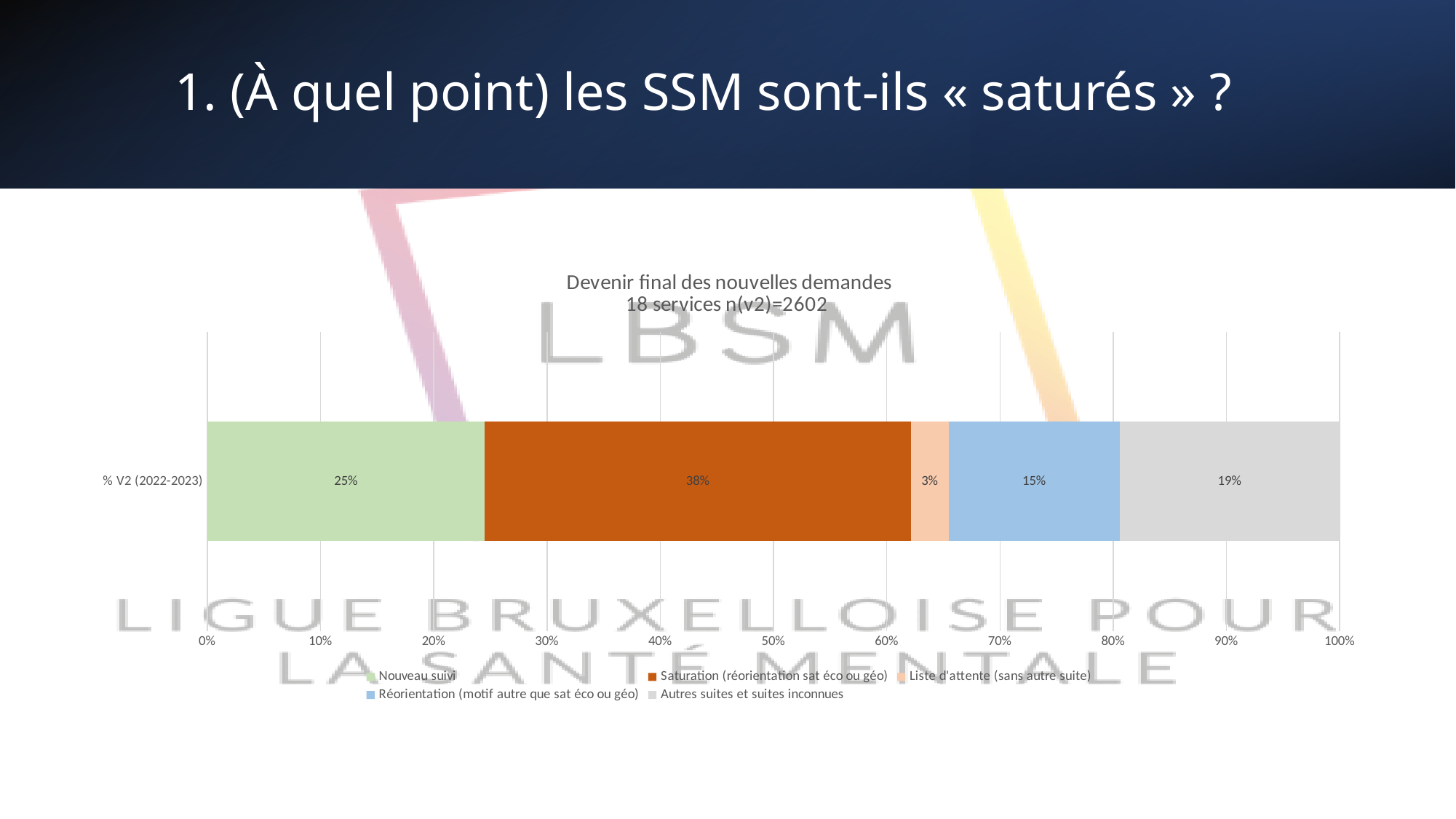
What is the value for Autres suites et suites inconnues? 19% What is the value for Liste d'attente (sans autre suite)? 3% What is the value for Nouveau suivi in the % V2 (2022-2023) bar? 25% What is the value for Réorientation (motif autre que sat éco ou géo)? 15% How many series does the legend list? 5 Which is larger: Autres suites et suites inconnues or Réorientation (motif autre que sat éco ou géo)? Autres suites et suites inconnues Which series has the smallest share of the bar? Liste d'attente (sans autre suite) What is the difference between the Saturation (réorientation sat éco ou géo) value and the Nouveau suivi value? 13% Which series has the largest share of the bar? Saturation (réorientation sat éco ou géo) What kind of chart is shown? Stacked bar chart What is the title of the chart? Devenir final des nouvelles demandes 18 services n(v2)=2602 What is the value for Saturation (réorientation sat éco ou géo)? 38%